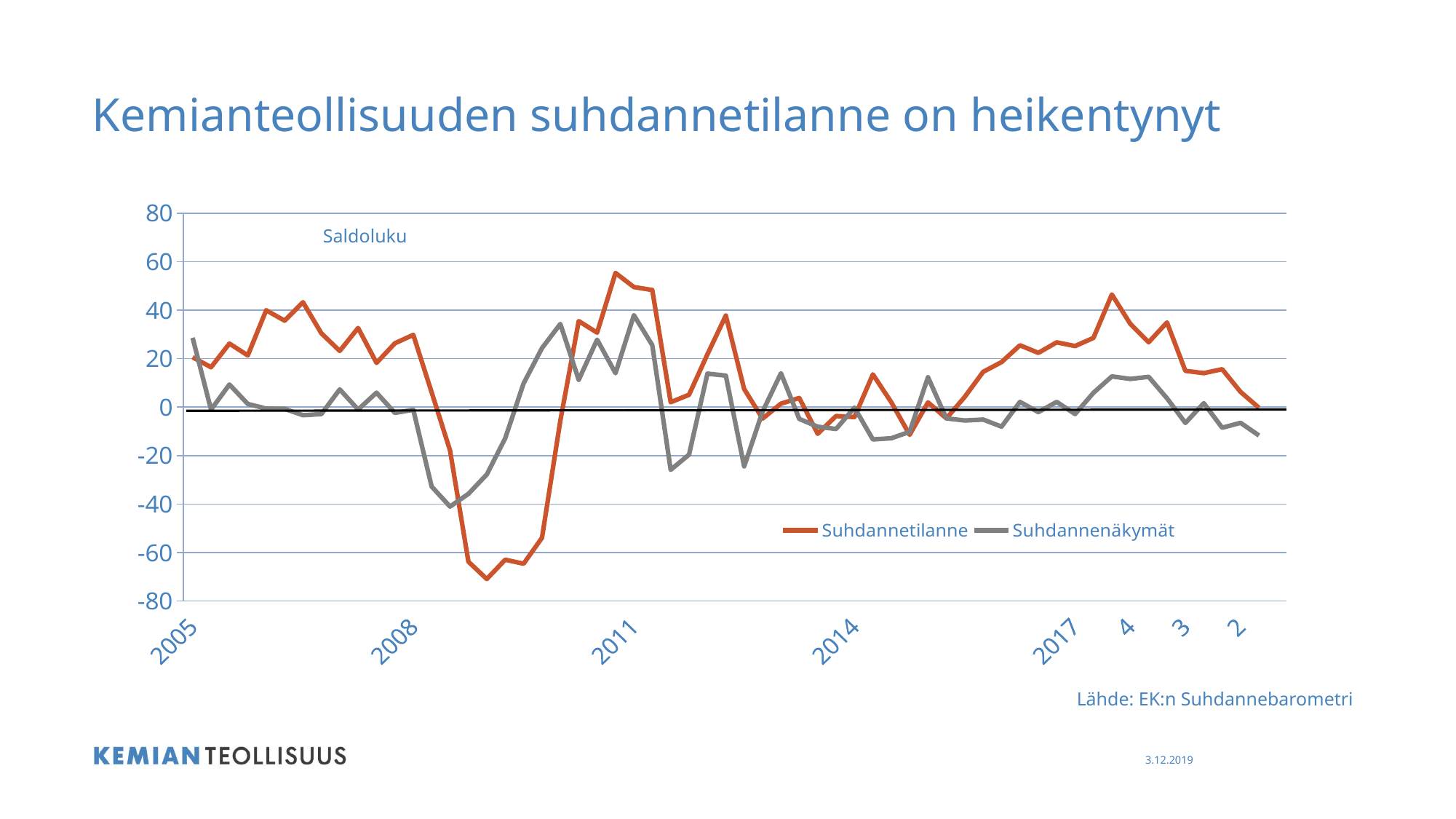
Is the highest value of the Suhdannenäkymät line (around 2011) greater or less than 20? greater Does the Suhdannetilanne line rise or fall from its peak around 2018 to the end of the chart? fall Which series reaches the lowest value anywhere on the chart? Suhdannetilanne How many series does the legend list? 2 Is the lowest value of the Suhdannetilanne line (around 2009) greater or less than -60? less What is the title of the slide above the chart? Kemianteollisuuden suhdannetilanne on heikentynyt Is the highest value of the Suhdannetilanne line (around 2011) greater or less than 40? greater Does the Suhdannetilanne line generally rise or fall between 2014 and 2017? rise At the right end of the chart, which series has the higher value, Suhdannetilanne or Suhdannenäkymät? Suhdannetilanne What kind of chart is shown on the slide? line chart What are the two series named in the legend? Suhdannetilanne and Suhdannenäkymät